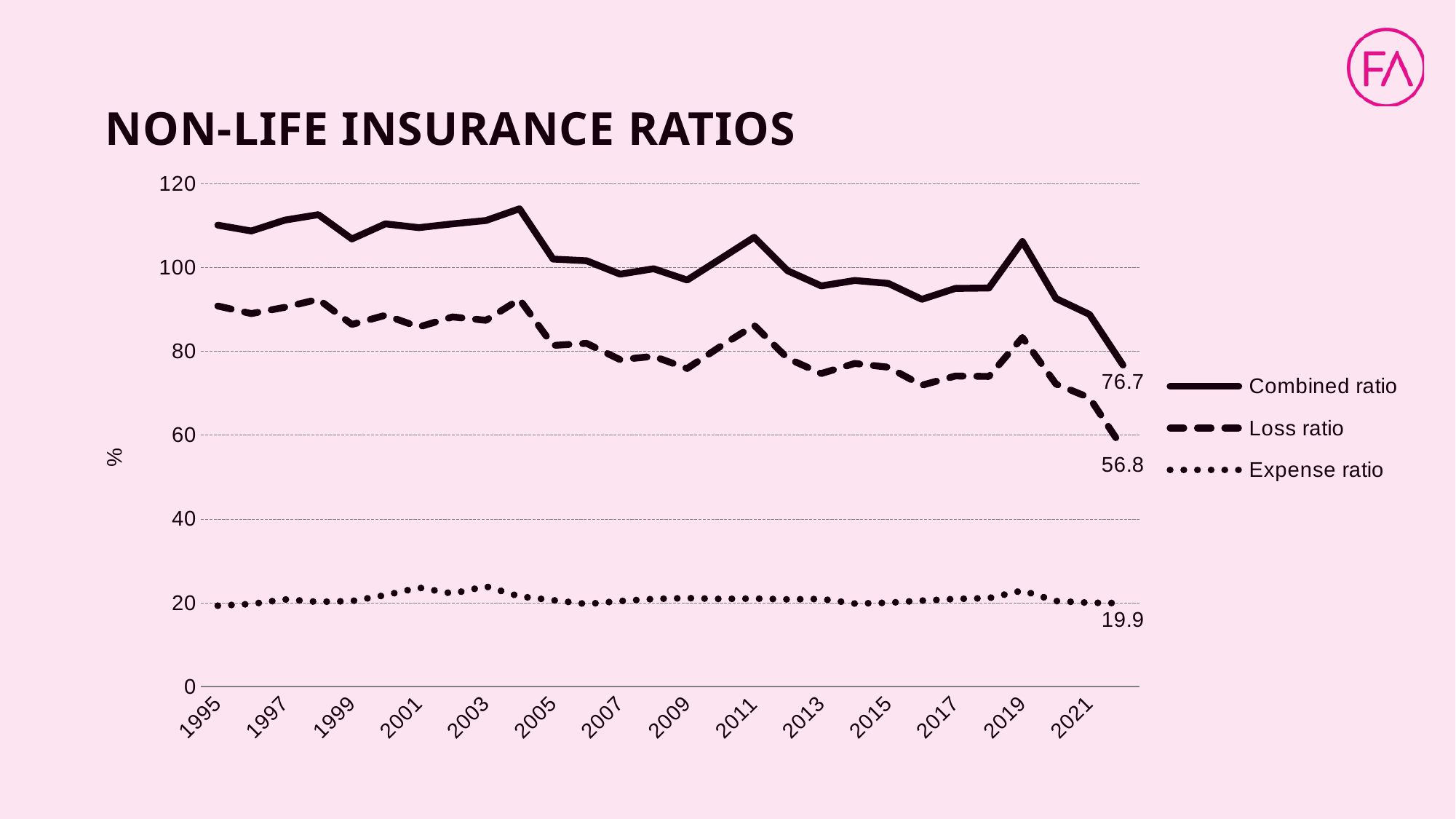
Which series has the lowest value at the final data point? Expense ratio What is the labelled value of the Loss ratio at the final data point? 56.8 What is the labelled value of the Combined ratio at the final data point? 76.7 What is the labelled value of the Expense ratio at the final data point? 19.9 What kind of chart is shown on the slide? Line chart Is the value of the Combined ratio in 1995 greater or less than 100? greater Does the Combined ratio generally rise or fall from 1995 to the end of the series? fall What is the title of the chart? NON-LIFE INSURANCE RATIOS Is the value of the Loss ratio in 2019 greater or less than 100? less What is the difference between the final labelled Combined ratio and the final labelled Loss ratio? 19.9 Which series has the highest value at the final data point? Combined ratio How many series does the legend list? 3